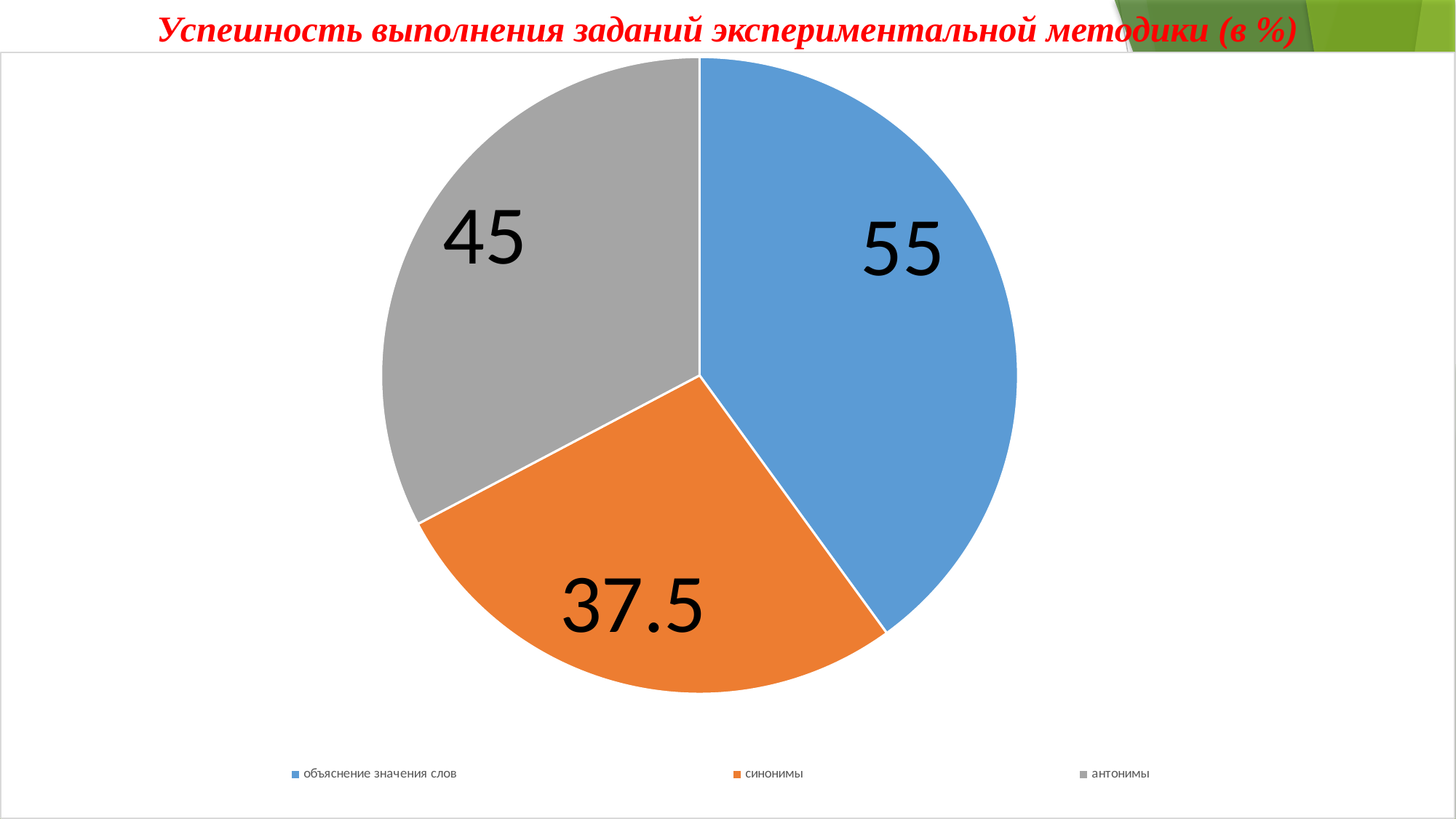
How many slices does the pie chart have? 3 What value is shown for the slice labelled синонимы? 37.5 Which category has the smallest slice of the pie? синонимы What is the difference between the values for антонимы and синонимы? 7.5 Which category has the largest slice of the pie? объяснение значения слов Which is larger, the value for антонимы or the value for синонимы? антонимы What value is shown for the slice labelled антонимы? 45 What value is shown for the slice labelled объяснение значения слов? 55 What colour is the slice for синонимы? orange What is the difference between the values for объяснение значения слов and синонимы? 17.5 What is the title of the chart? Успешность выполнения заданий экспериментальной методики (в %) What kind of chart is shown on the slide? pie chart